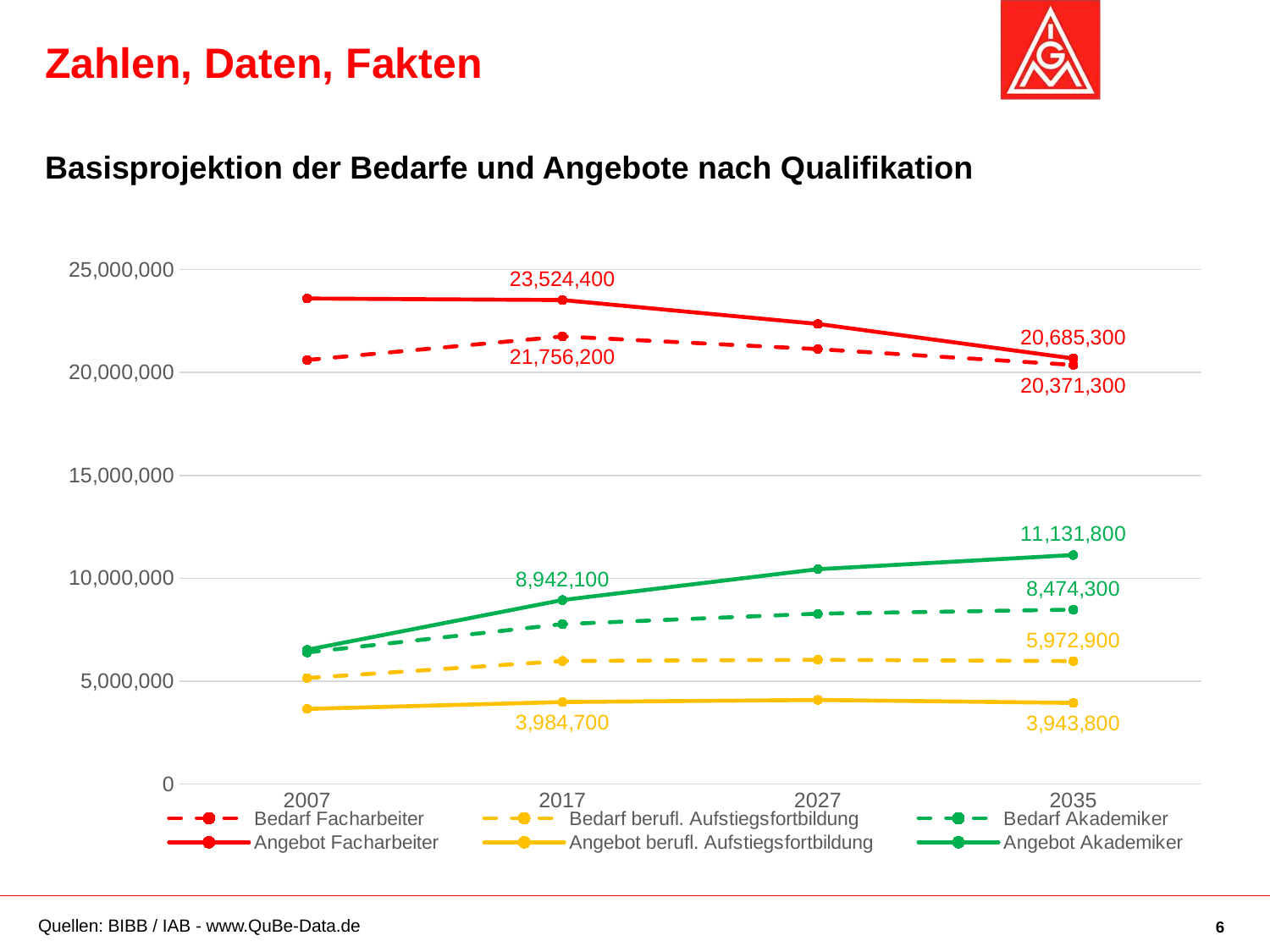
What is the value for Bedarf Akademiker in 2035? 8,474,300 What is the value for Bedarf Facharbeiter in 2017? 21,756,200 What is the value for Angebot berufl. Aufstiegsfortbildung in 2017? 3,984,700 What is the value for Angebot Akademiker in 2035? 11,131,800 What is the value for Angebot Facharbeiter in 2017? 23,524,400 How many series does the legend list? 6 What kind of chart is shown on the slide? line chart Does the Angebot Akademiker line rise or fall from 2007 to 2035? rise Is the value for Angebot Akademiker in 2027 greater or less than 10,000,000? greater Which is larger in 2035, Angebot Akademiker or Bedarf Akademiker? Angebot Akademiker How many years are shown on the x axis? 4 By how much does Angebot Facharbeiter exceed Bedarf Facharbeiter in 2017? 1,768,200